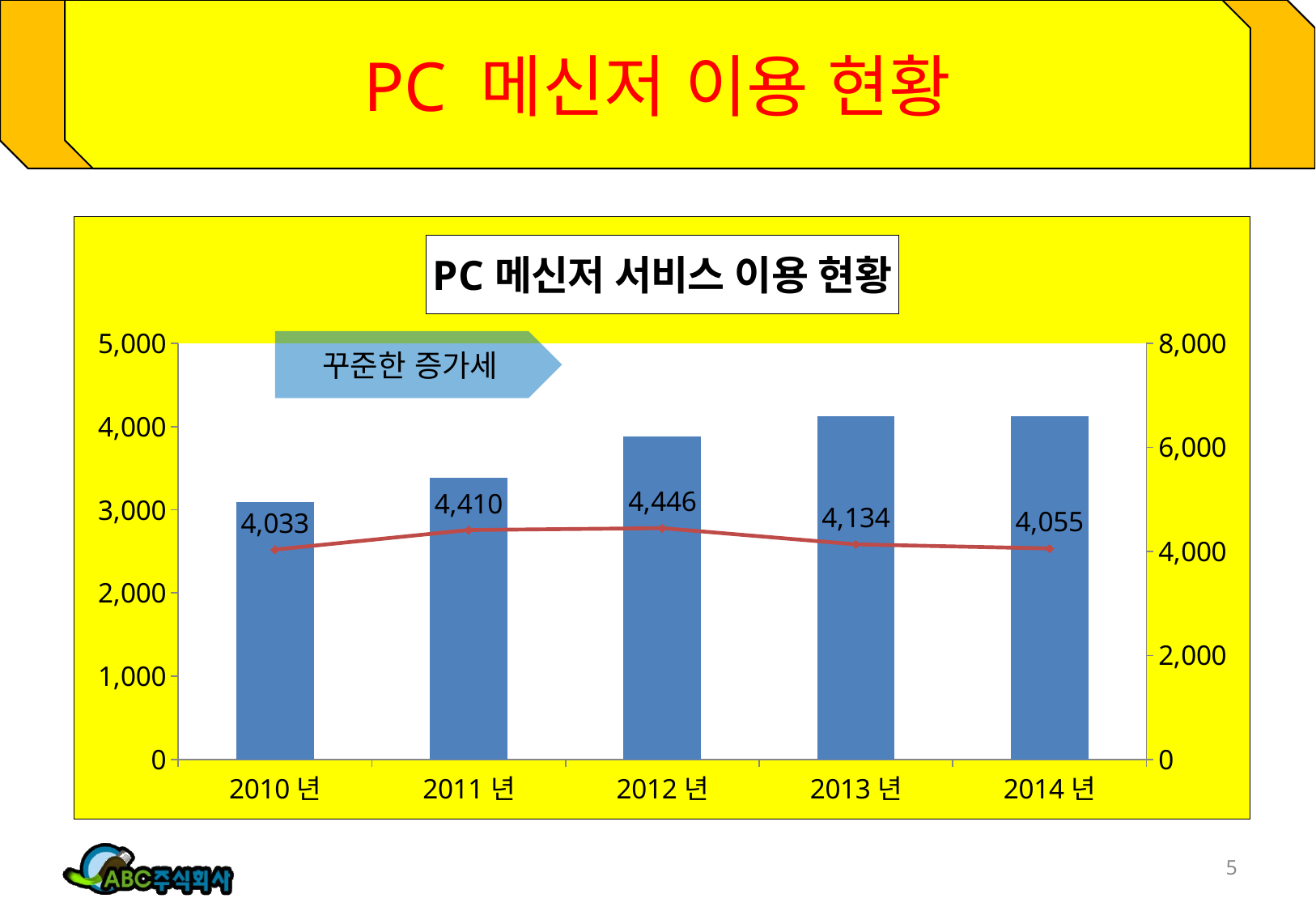
On the left axis, is the bar for 2014 년 greater or less than 3,000? greater What value is labelled on the line for 2010 년? 4,033 How many years are shown on the x axis? 5 What value is labelled on the line for 2012 년? 4,446 Which year has the highest labelled line value? 2012 년 What is the difference between the labelled line values for 2012 년 and 2010 년? 413 Do the bars rise or fall from 2010 년 to 2013 년? rise Which has the larger labelled line value, 2011 년 or 2013 년? 2011 년 Which year has the lowest labelled line value? 2010 년 What is the title of the chart? PC 메신저 서비스 이용 현황 What value is labelled on the line for 2014 년? 4,055 On the left axis, is the bar for 2010 년 greater or less than 4,000? less